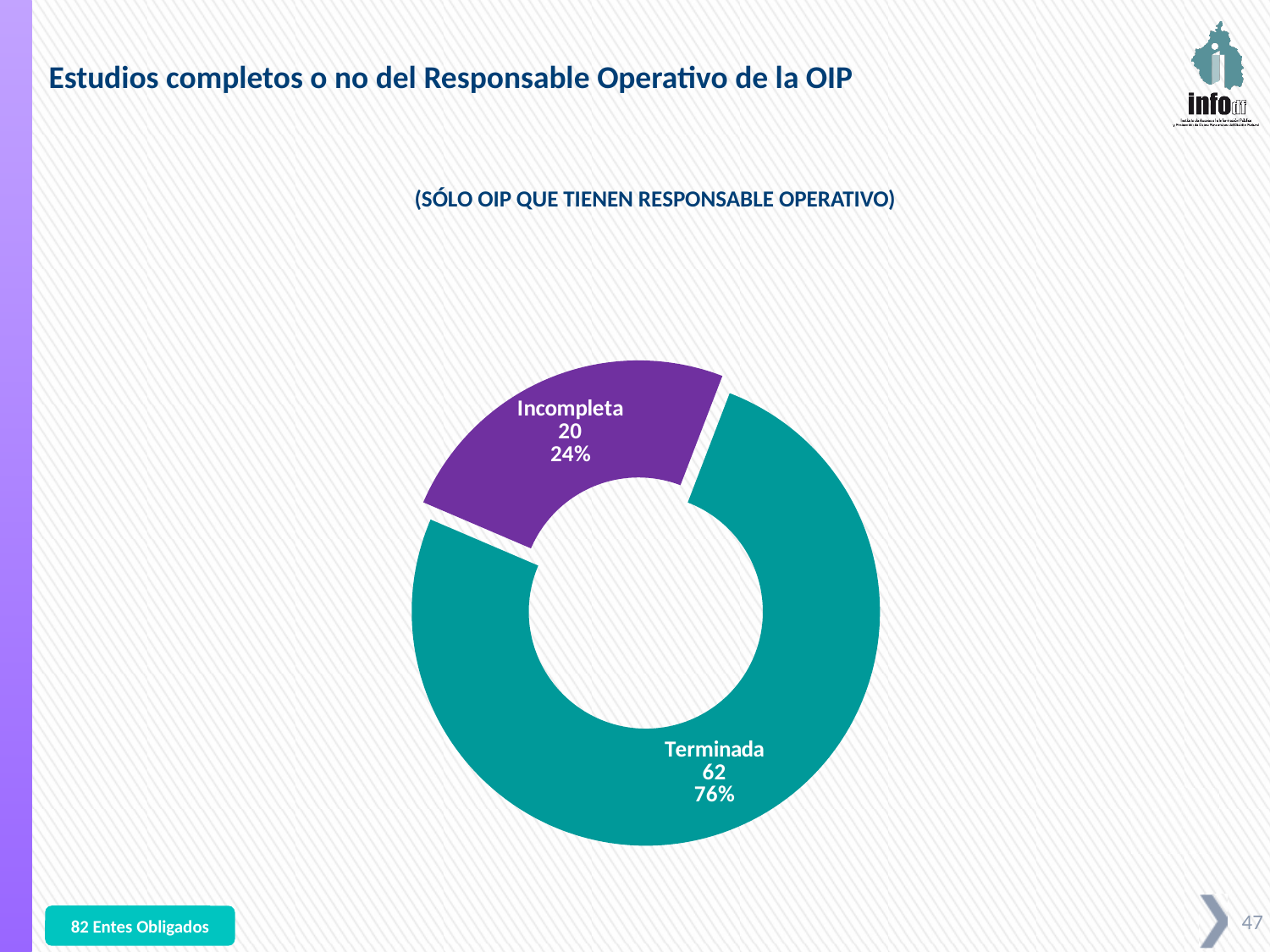
Which category has the smallest slice? Incompleta What is the difference between the counts for Terminada and Incompleta? 42 What percentage share does Terminada have? 76% Which category has the largest slice? Terminada What is the count for Terminada? 62 What is the total of the two categories shown in the chart? 82 How many categories are shown in the chart? 2 What colour is the Incompleta slice? Purple What percentage share does Incompleta have? 24% What kind of chart is shown on the slide? Pie chart (doughnut) Which is larger, the count for Terminada or the count for Incompleta? Terminada What is the count for Incompleta? 20